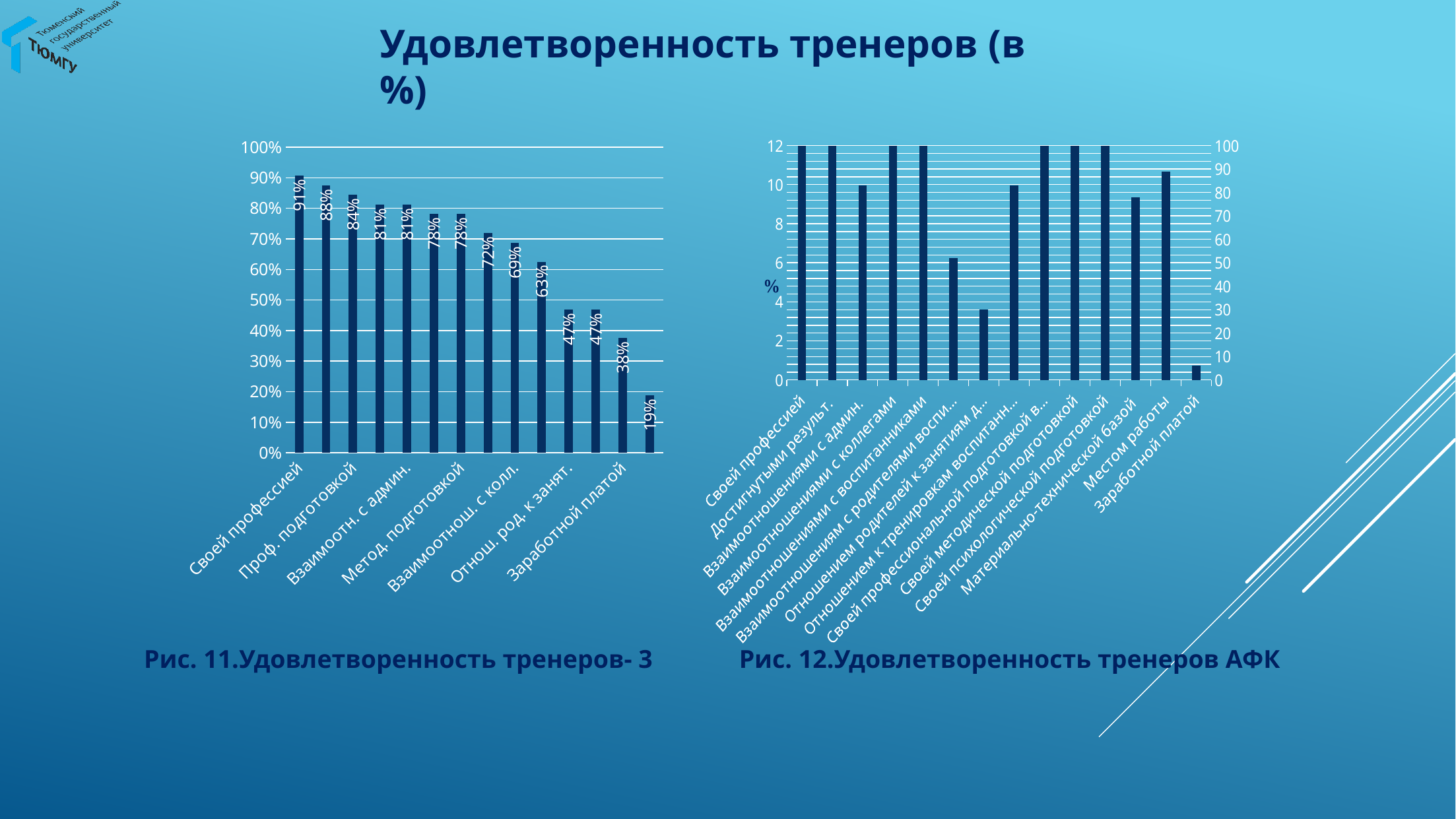
In the left chart (Рис. 11), what is the lowest value shown? 19% In the left chart (Рис. 11), what is the highest value shown? 91% In the right chart (Рис. 12), which is larger: the value for 'Своей профессией' or for 'Заработной платой'? Своей профессией In the right chart (Рис. 12), which category has the lowest value? Заработной платой What kind of chart is the left chart (Рис. 11)? bar chart In the left chart (Рис. 11), what is the difference between the highest value (91%) and the lowest value (19%)? 72% How many categories are shown in the right chart (Рис. 12)? 14 In the right chart (Рис. 12), is the value for 'Заработной платой' greater or less than 2 on the left axis? less In the left chart (Рис. 11), how many bars have a value above 80%? 5 How many bars are plotted in the left chart (Рис. 11)? 14 In the right chart (Рис. 12), is the value for 'Материально-технической базой' greater or less than 10 on the left axis? less In the right chart (Рис. 12), what is the value for 'Своей профессией' on the left axis? 12